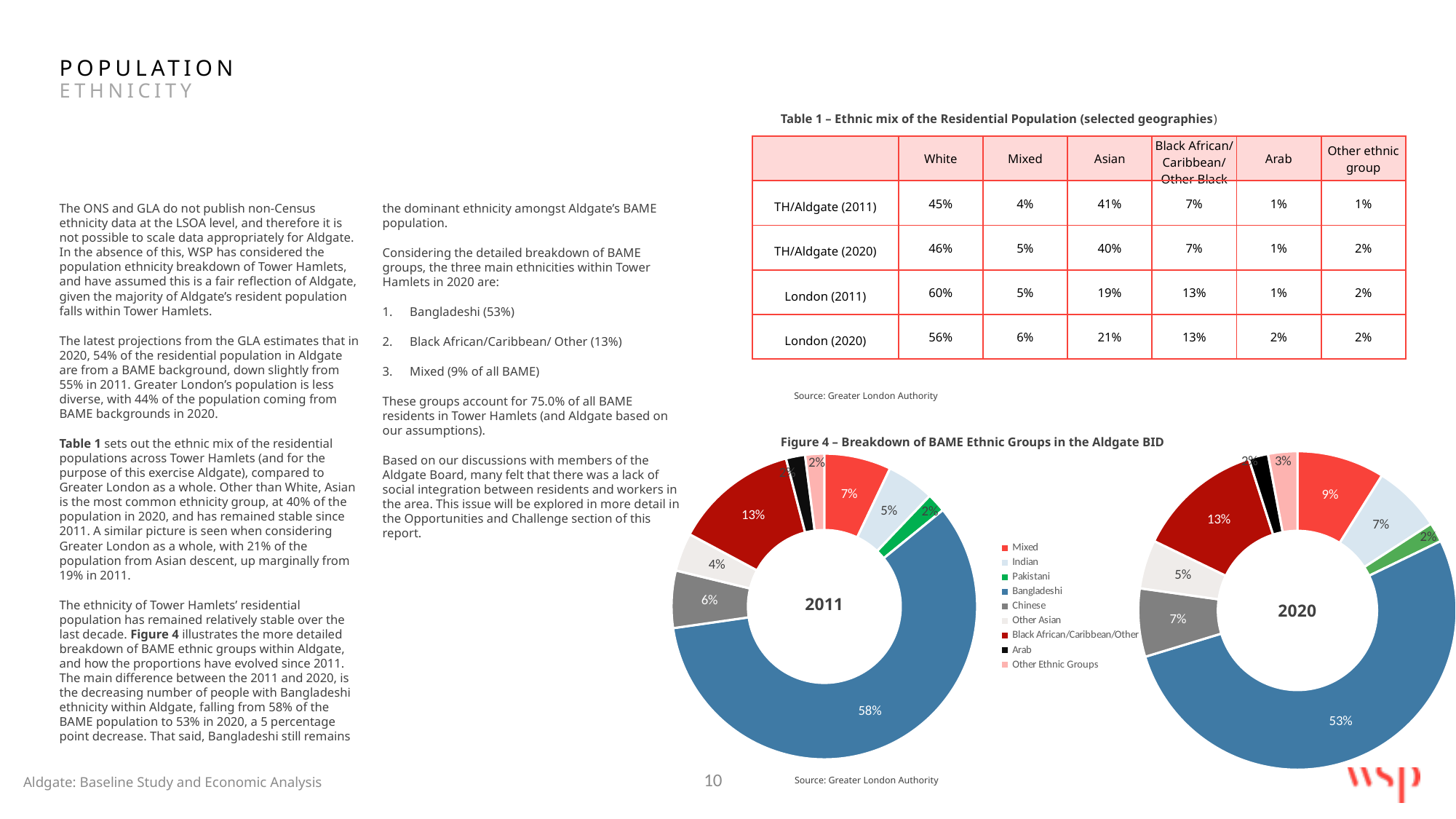
What type of chart is used in Figure 4 for 2011 and 2020? Donut (pie) chart In the 2011 donut chart, what share of the BAME population is Bangladeshi? 58% In the 2011 donut chart, what is the value for Black African/Caribbean/Other? 13% In the 2011 donut chart, what is the difference between the Chinese share and the Other Asian share? 2 percentage points In the 2011 donut chart, which ethnic group has the largest share? Bangladeshi What is the title of Figure 4? Breakdown of BAME Ethnic Groups in the Aldgate BID In the 2020 donut chart, what is the value for Chinese? 7% In the 2020 donut chart, what is the value for Mixed? 9% In the 2020 donut chart, which is larger, the share for Indian or the share for Other Asian? Indian How many ethnic groups does the legend of Figure 4 list? 9 By how many percentage points did the Bangladeshi share fall between the 2011 and 2020 donut charts? 5 percentage points In the 2020 donut chart, what share of the BAME population is Bangladeshi? 53%